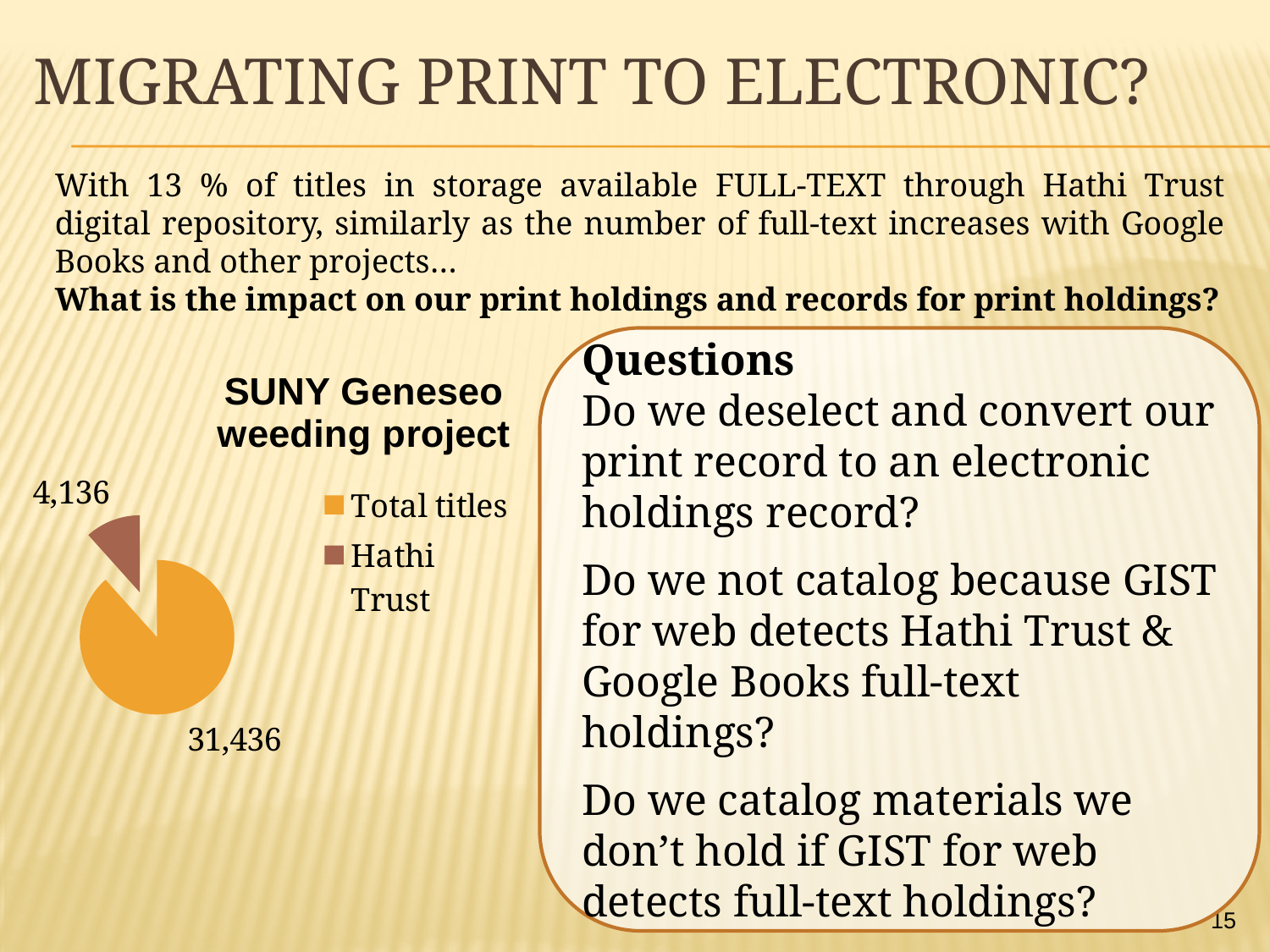
Which slice of the pie chart is the largest? Total titles What is the value shown for Total titles in the pie chart? 31,436 Which is larger in the pie chart, Total titles or Hathi Trust? Total titles What colour is the Hathi Trust slice in the pie chart? Brown How many entries does the pie chart's legend list? 2 What is the sum of the two values shown in the pie chart? 35,572 How many slices does the pie chart have? 2 What is the value shown for Hathi Trust in the pie chart? 4,136 What is the title of the pie chart? SUNY Geneseo weeding project Which slice of the pie chart is the smallest? Hathi Trust What is the difference between the Total titles value and the Hathi Trust value in the pie chart? 27,300 What type of chart is shown on the slide? Pie chart